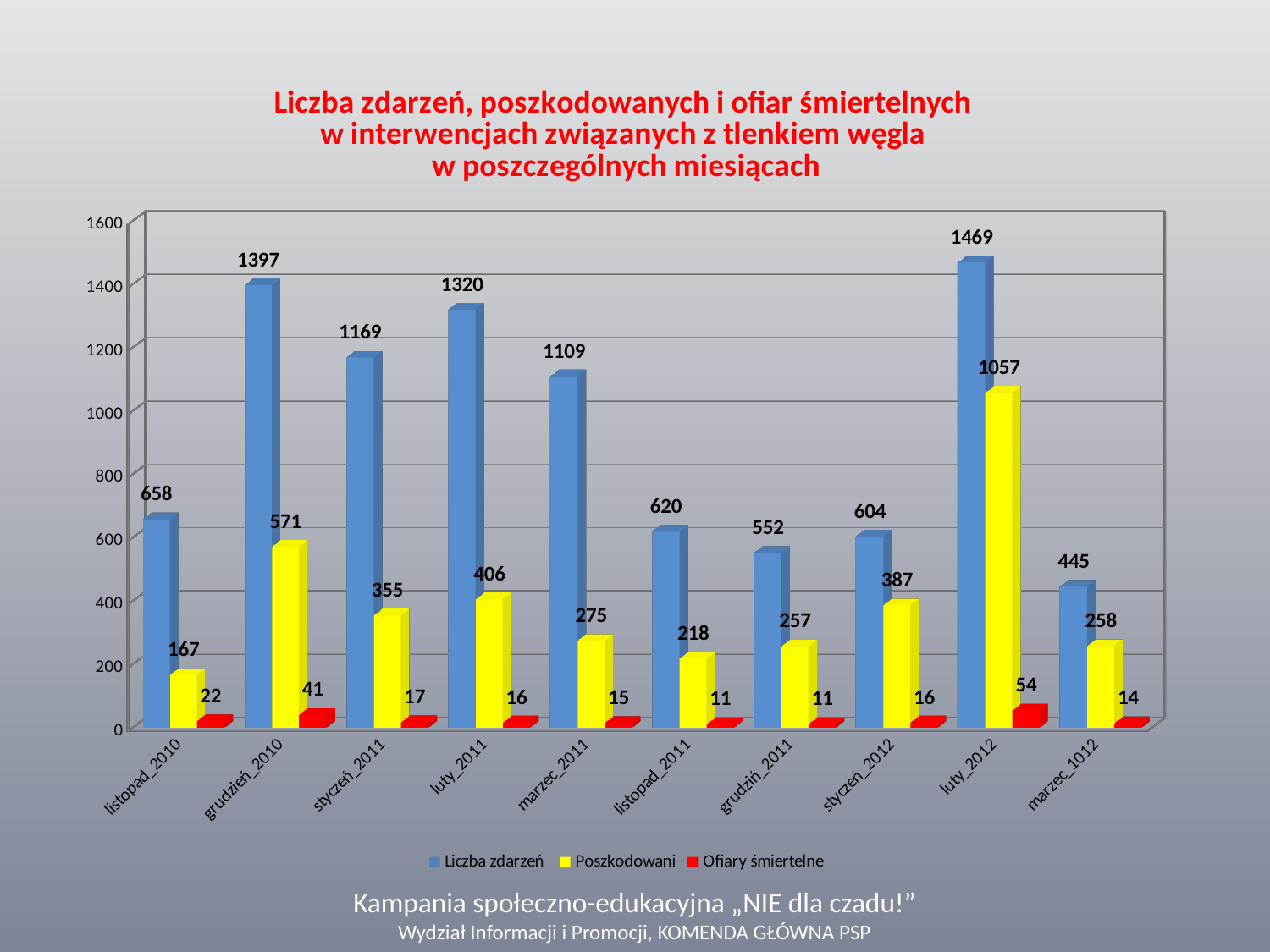
Which month has the lowest value of Poszkodowani? listopad_2010 Which is larger: Poszkodowani for styczeń_2012 or Poszkodowani for luty_2011? luty_2011 Which colour represents the Ofiary śmiertelne series? red What is the value of Poszkodowani for grudzień_2010? 571 What is the value of Ofiary śmiertelne for luty_2012? 54 Which month has the highest value of Liczba zdarzeń? luty_2012 How many months are shown on the x axis? 10 What is the value of Liczba zdarzeń for luty_2012? 1469 How many series does the legend list? 3 Is the value of Liczba zdarzeń for marzec_1012 greater or less than 600? less What kind of chart is shown on the slide? bar chart What is the difference between Liczba zdarzeń for grudzień_2010 and luty_2011? 77